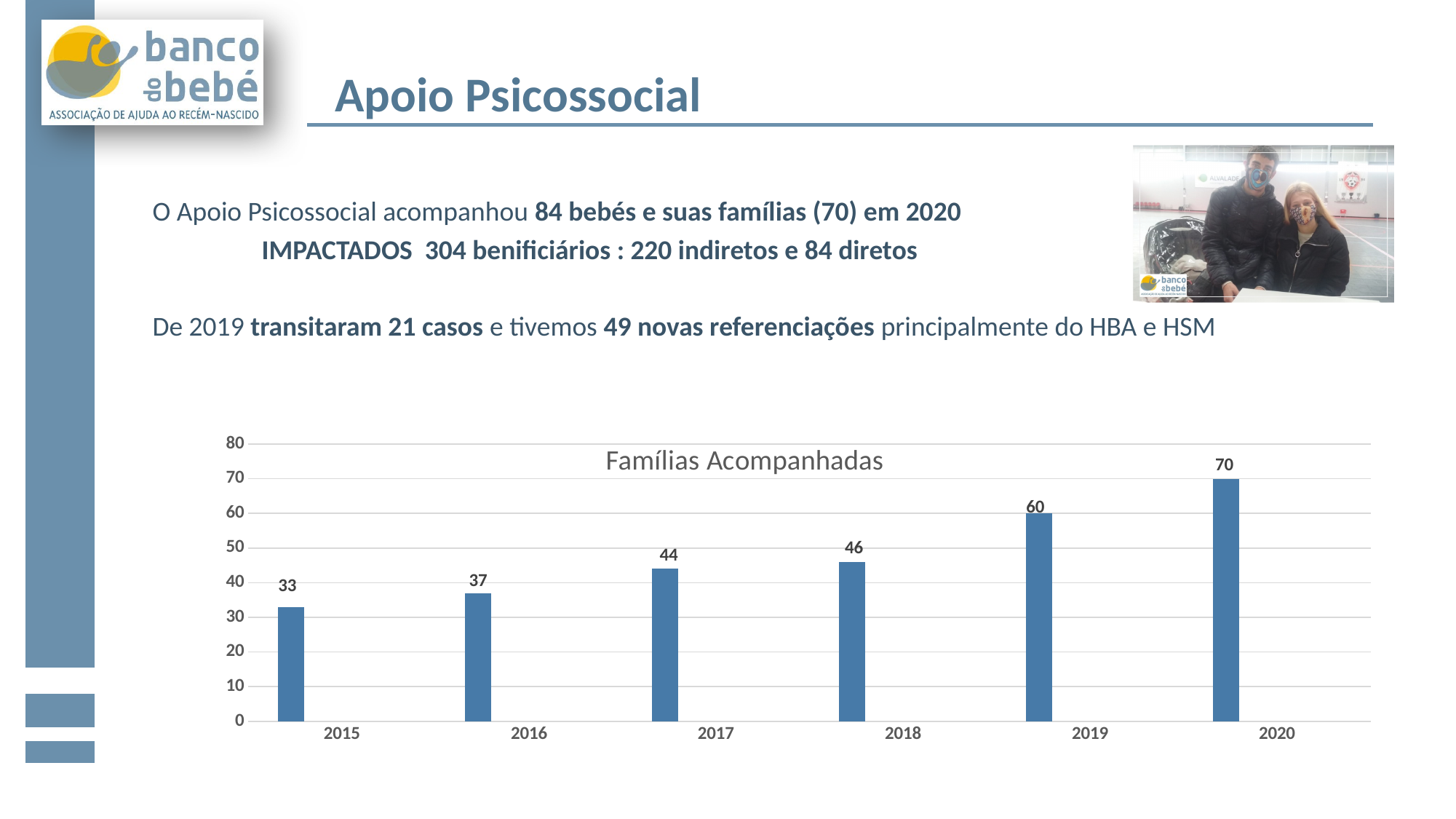
Which year has the highest value in the Famílias Acompanhadas chart? 2020 Do the values in the Famílias Acompanhadas chart rise or fall from 2015 to 2020? rise What is the difference between the values for 2017 and 2016 in the Famílias Acompanhadas chart? 7 What kind of chart is the Famílias Acompanhadas chart? bar chart How many years are shown in the Famílias Acompanhadas chart? 6 Which year has the lowest value in the Famílias Acompanhadas chart? 2015 What is the difference between the values for 2020 and 2019 in the Famílias Acompanhadas chart? 10 Which is larger in the Famílias Acompanhadas chart, the value for 2019 or the value for 2018? 2019 What is the value for 2020 in the Famílias Acompanhadas chart? 70 What is the value for 2015 in the Famílias Acompanhadas chart? 33 What is the value for 2018 in the Famílias Acompanhadas chart? 46 Is the value for 2019 in the Famílias Acompanhadas chart greater or less than 50? greater